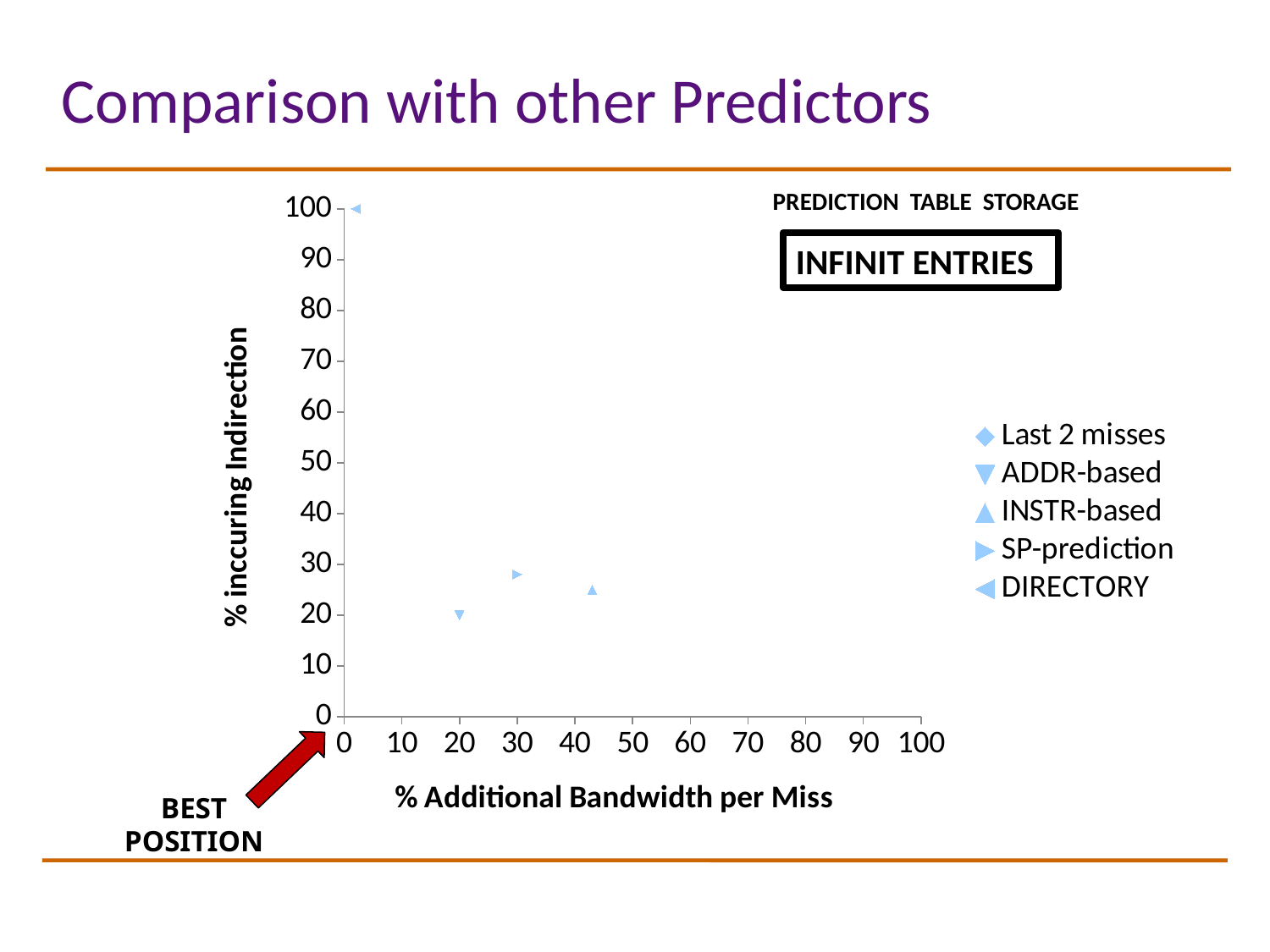
Is the % Additional Bandwidth per Miss for INSTR-based greater or less than 40? greater How many series does the legend list? 5 Is the % incurring Indirection for SP-prediction greater or less than 40? less Which has a higher % incurring Indirection, SP-prediction or ADDR-based? SP-prediction What kind of chart is shown on the slide? scatter chart Is the % incurring Indirection for DIRECTORY greater or less than 90? greater Which series has the highest % incurring Indirection? DIRECTORY Among the plotted points, which series has the lowest % incurring Indirection? ADDR-based Which has a higher % Additional Bandwidth per Miss, INSTR-based or SP-prediction? INSTR-based What is the title of the x axis? % Additional Bandwidth per Miss What text appears in the boxed label under PREDICTION TABLE STORAGE? INFINIT ENTRIES